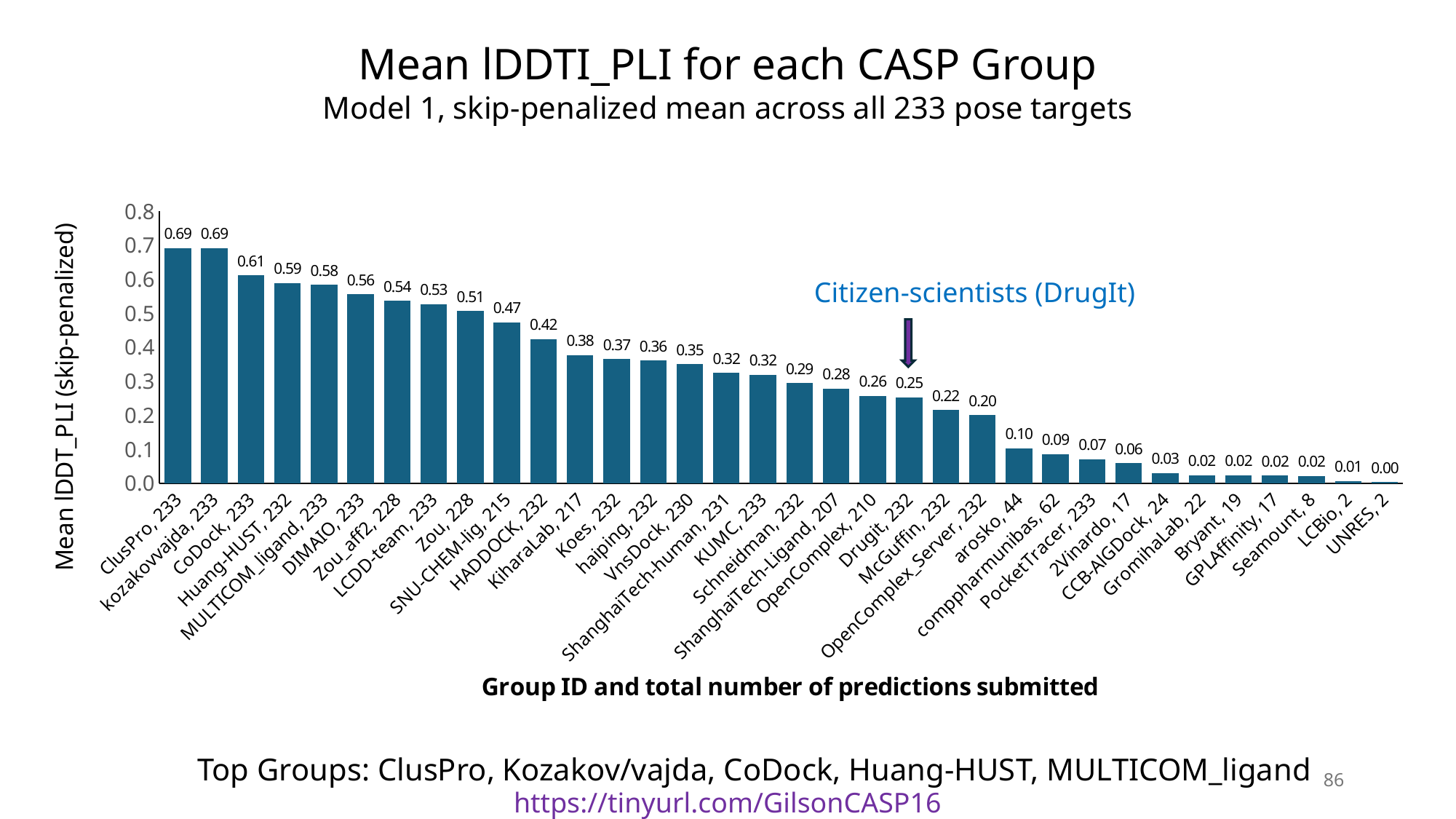
Do the values rise or fall moving from left to right along the x axis? fall Is the mean lDDT_PLI for arosko greater or less than 0.2? less What is the label of the y axis? Mean lDDT_PLI (skip-penalized) How many predictions did the DrugIt group submit, according to the x-axis label? 232 How many CASP groups are shown in the chart? 34 Which group has a higher mean lDDT_PLI, Koes or McGuffin? Koes What is the mean lDDT_PLI value for HADDOCK? 0.42 Which group has the lowest mean lDDT_PLI? UNRES What is the difference between the mean lDDT_PLI of ClusPro and DIMAIO? 0.13 What is the mean lDDT_PLI value for CoDock? 0.61 What is the mean lDDT_PLI value for DrugIt, the citizen-scientists group? 0.25 What type of chart is shown on the slide? bar chart